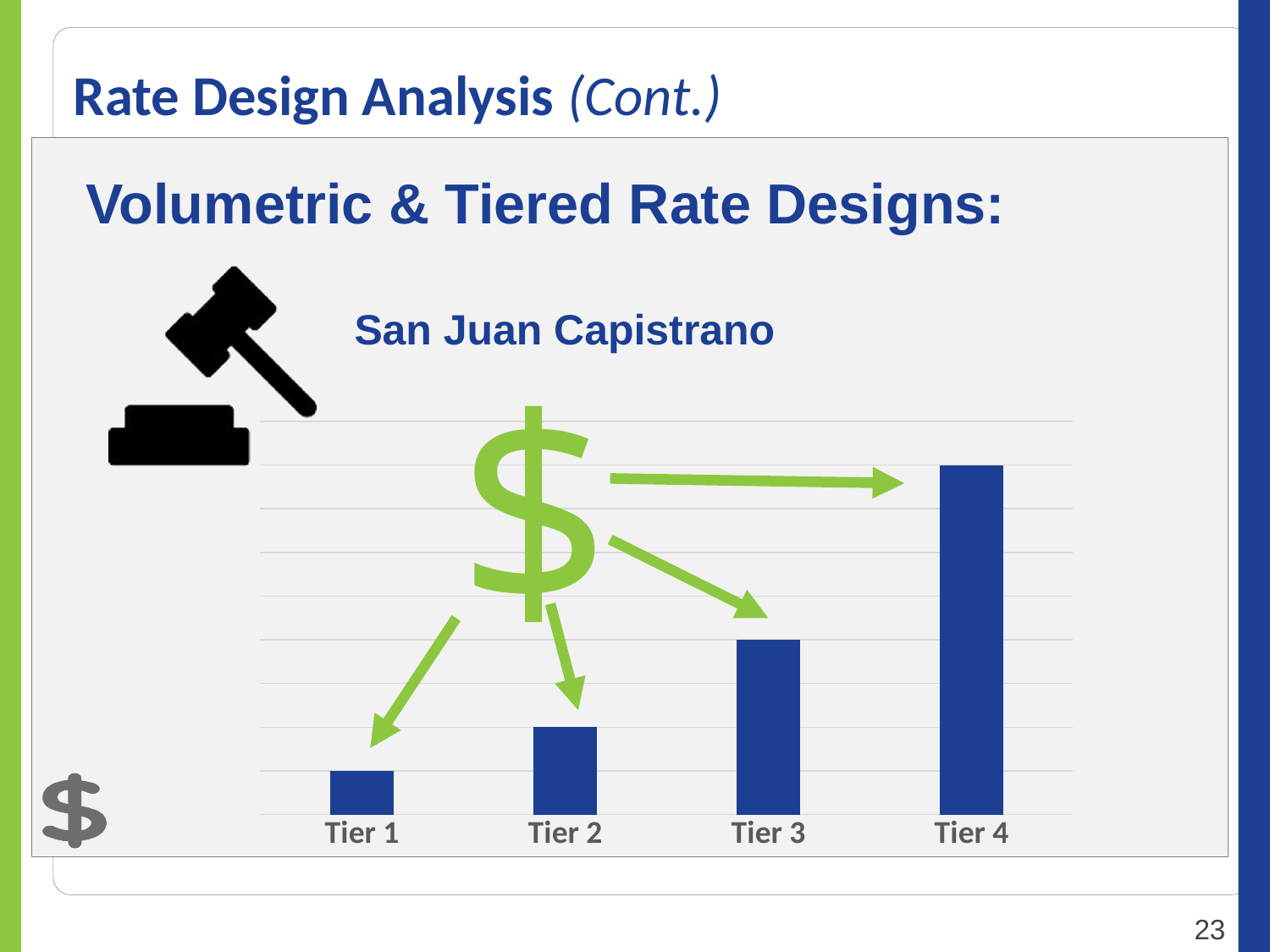
What is the label of the first category on the x axis? Tier 1 How many categories are plotted on the chart? 4 Which bar is taller, Tier 2 or Tier 3? Tier 3 Which tier has the shortest bar? Tier 1 What kind of chart is shown on the slide? bar chart Which bar is taller, Tier 1 or Tier 4? Tier 4 What colour are the bars in the chart? blue Which tier has the tallest bar? Tier 4 Do the bar heights rise or fall from Tier 1 to Tier 4? rise